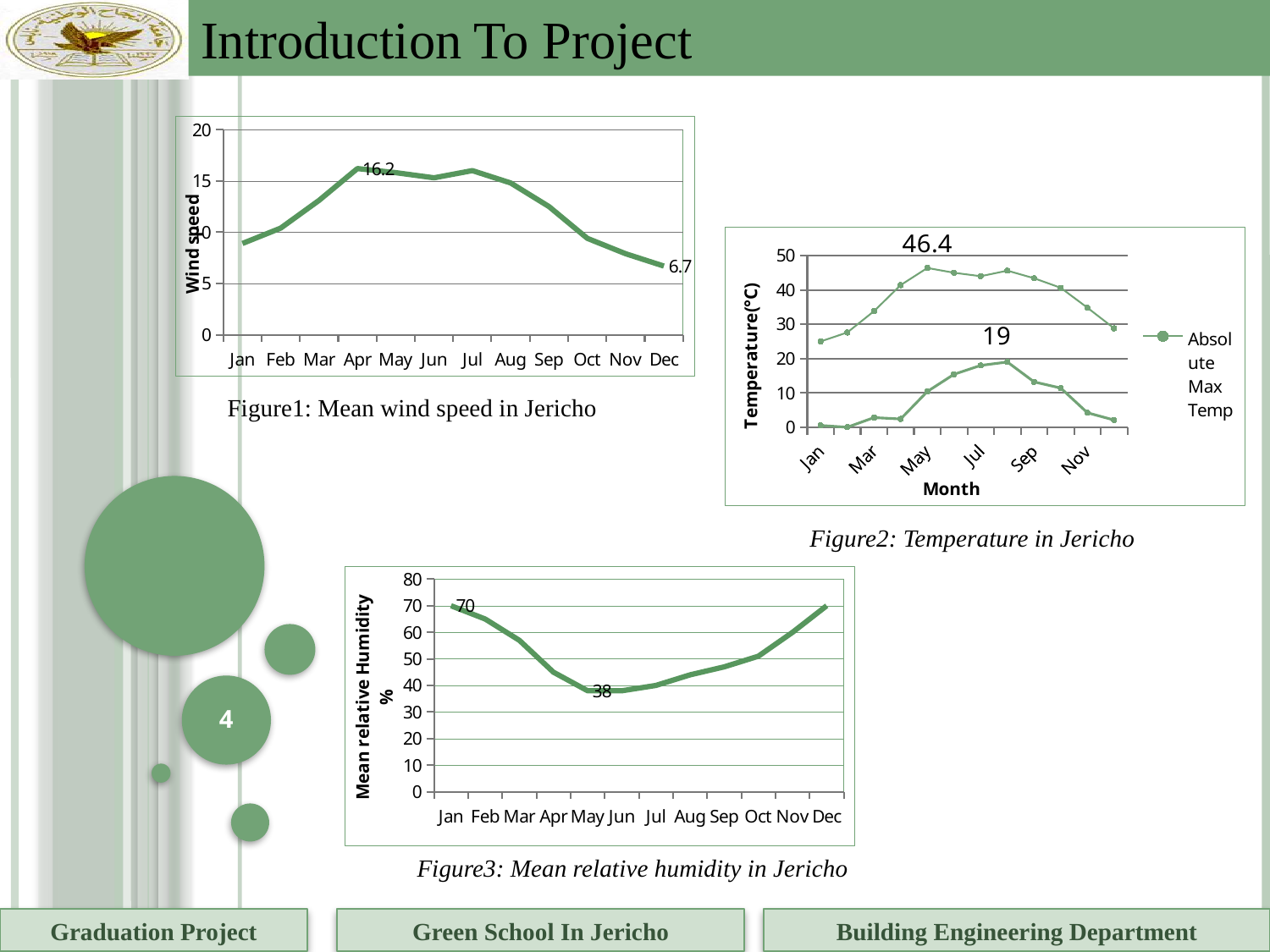
In Figure1 (Mean wind speed in Jericho), what kind of chart is shown? line chart In Figure2 (Temperature in Jericho), what series name is shown in the legend? Absolute Max Temp In Figure1 (Mean wind speed in Jericho), what is the difference between the labeled values for Apr and Dec? 9.5 In Figure2 (Temperature in Jericho), what is the difference between the two labeled values 46.4 and 19? 27.4 In Figure1 (Mean wind speed in Jericho), what is the wind speed value labeled for Apr? 16.2 In Figure2 (Temperature in Jericho), what is the value labeled at the peak of the lower line? 19 In Figure1 (Mean wind speed in Jericho), how many months are shown on the x axis? 12 In Figure1 (Mean wind speed in Jericho), is the value for Sep greater or less than 15? less In Figure1 (Mean wind speed in Jericho), what is the wind speed value labeled for Dec? 6.7 In Figure3 (Mean relative humidity in Jericho), what is the lowest value labeled on the chart? 38 In Figure2 (Temperature in Jericho), what is the highest value labeled on the chart? 46.4 In Figure3 (Mean relative humidity in Jericho), what is the humidity value labeled for Jan? 70